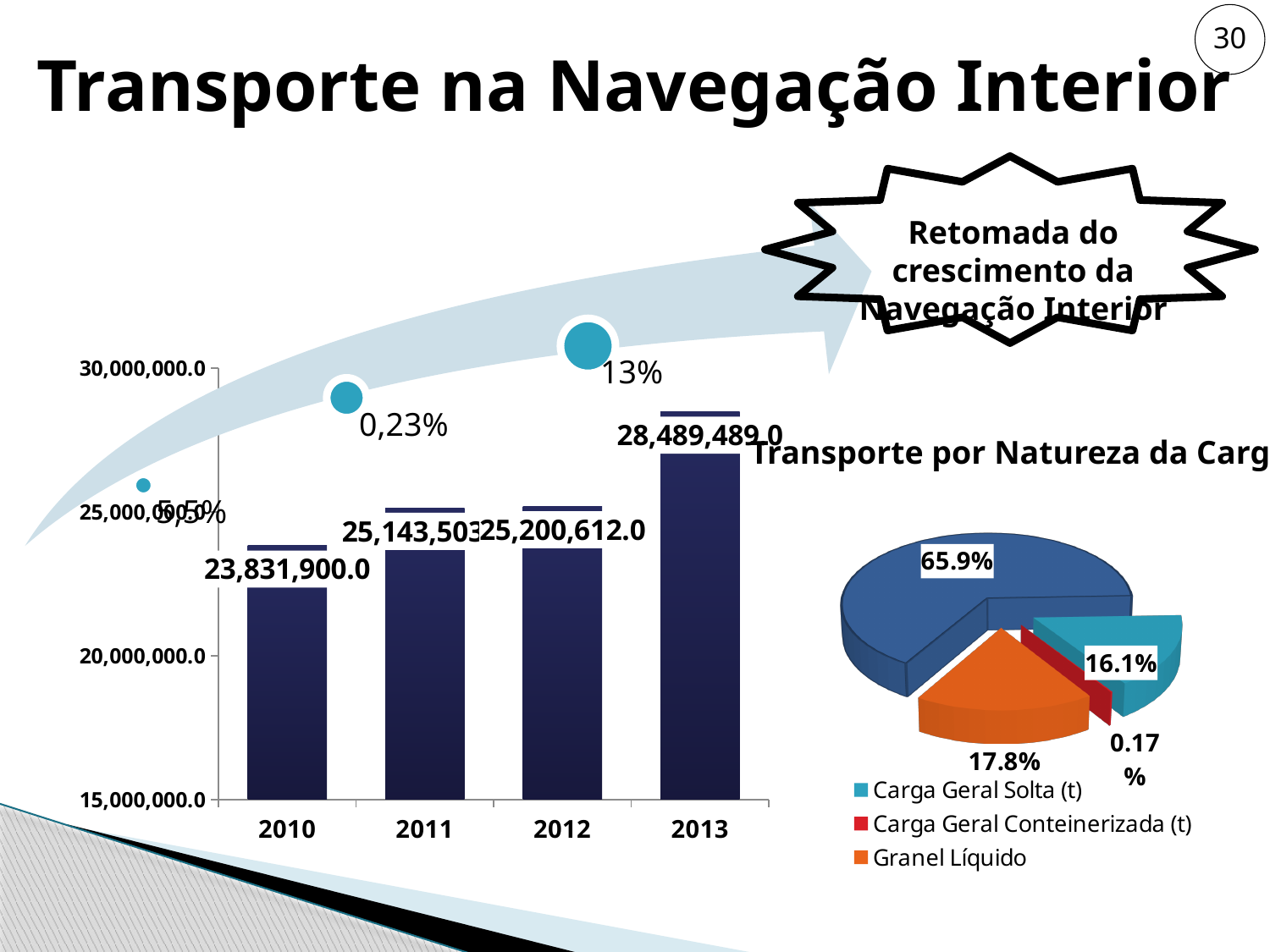
In the bar chart on the left, what is the value for 2012? 25,200,612.0 In the bar chart on the left, what is the value for 2013? 28,489,489.0 In the bar chart on the left, is the value for 2013 greater or less than 25,000,000.0? greater In the bar chart on the left, which year has the highest value? 2013 In the pie chart 'Transporte por Natureza da Carga', what share does the largest slice have? 65.9% How many entries does the legend of the pie chart 'Transporte por Natureza da Carga' list? 3 In the bar chart on the left, which year has the lowest value? 2010 In the bar chart on the left, what is the difference between the 2013 and 2010 values? 4,657,589.0 In the pie chart 'Transporte por Natureza da Carga', what share is labelled on the orange slice (Granel Líquido)? 17.8% In the bar chart on the left, how many years are shown on the x axis? 4 In the bar chart on the left, what is the value for 2010? 23,831,900.0 In the bar chart on the left, do the values rise or fall from 2010 to 2013? rise